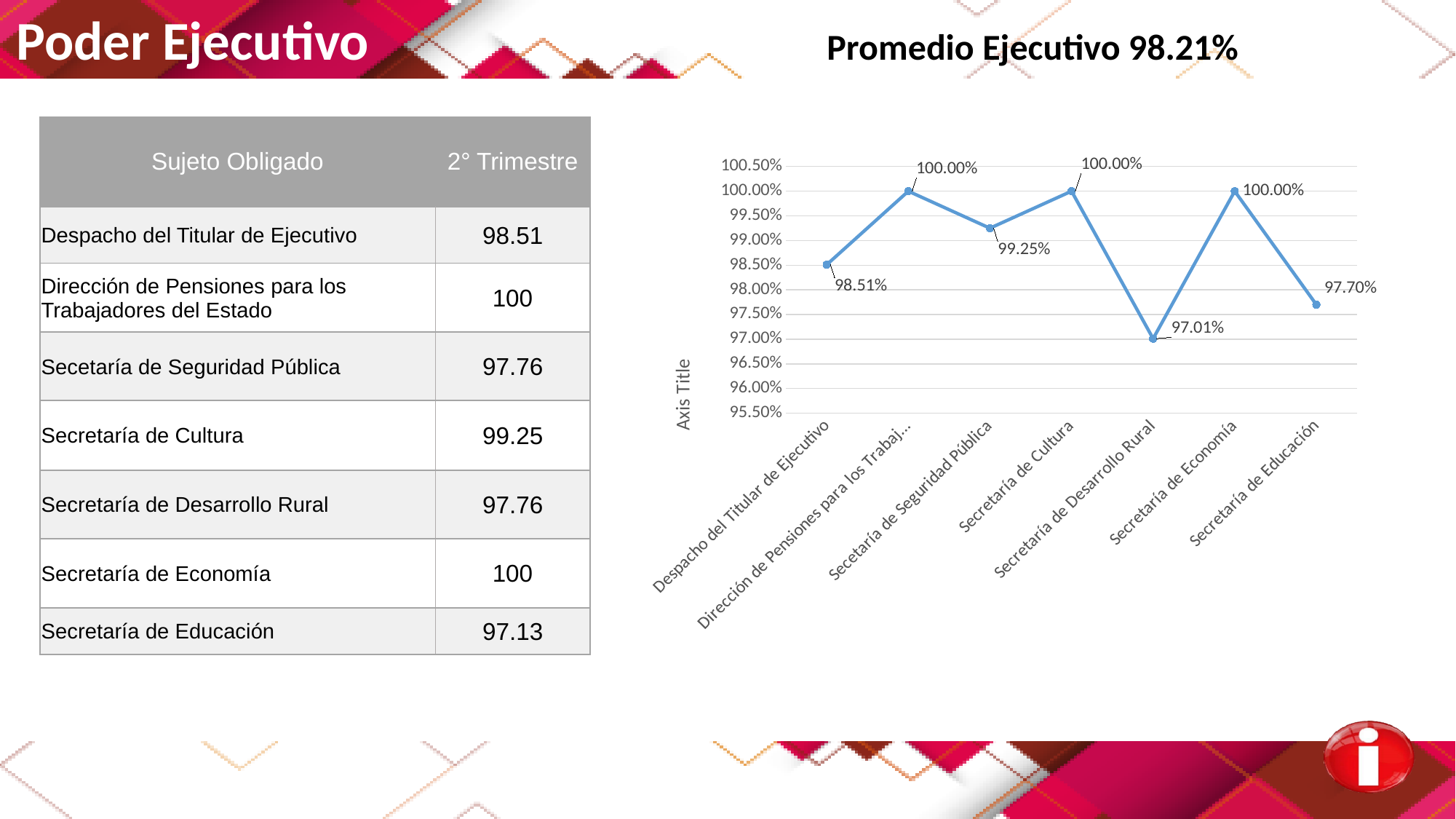
What is the difference between the values for Secretaría de Seguridad Pública and Secretaría de Desarrollo Rural on the line chart? 2.24% How many data points are plotted on the line chart? 7 Does the line rise or fall between Secretaría de Cultura and Secretaría de Desarrollo Rural? fall What is the label on the vertical axis of the line chart? Axis Title Is the value for Secretaría de Desarrollo Rural on the line chart greater or less than 98.00%? less On the line chart, which is larger: the value for Despacho del Titular de Ejecutivo or the value for Secretaría de Educación? Despacho del Titular de Ejecutivo What value does the line chart show for Secretaría de Desarrollo Rural? 97.01% What value does the line chart show for Secretaría de Seguridad Pública? 99.25% What kind of chart is shown on the slide? line chart Which category has the lowest value on the line chart? Secretaría de Desarrollo Rural What value does the line chart show for Secretaría de Educación? 97.70% What value does the line chart show for Despacho del Titular de Ejecutivo? 98.51%